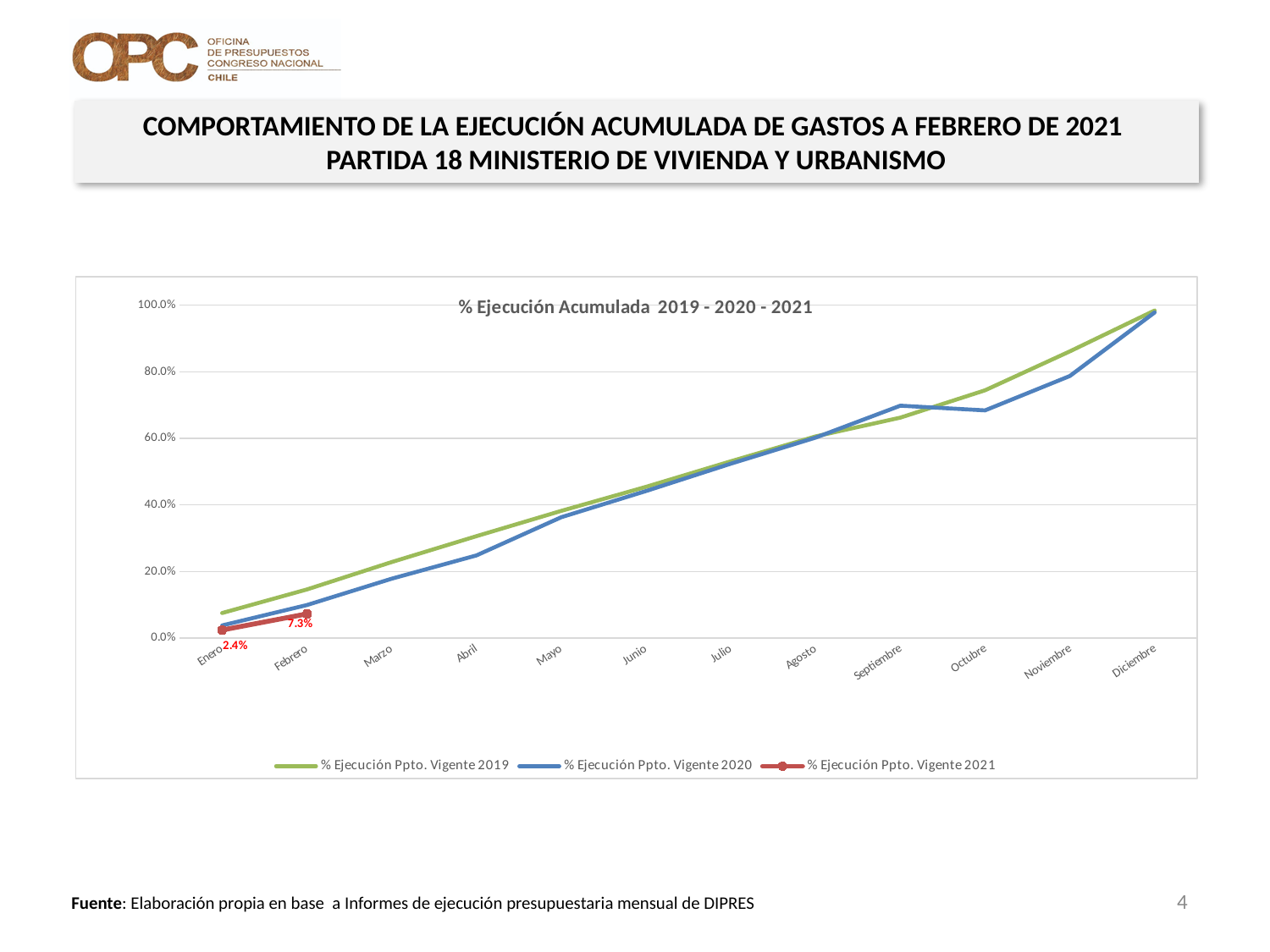
What kind of chart is shown on the slide? line chart Is the value for % Ejecución Ppto. Vigente 2020 in Junio greater or less than 60%? less Does the % Ejecución Ppto. Vigente 2019 series rise or fall from Enero to Diciembre? rise What is the value of % Ejecución Ppto. Vigente 2021 in Febrero? 7.3% What is the value of % Ejecución Ppto. Vigente 2021 in Enero? 2.4% What is the title of the chart? % Ejecución Acumulada 2019 - 2020 - 2021 In Noviembre, which series is higher: % Ejecución Ppto. Vigente 2019 or % Ejecución Ppto. Vigente 2020? % Ejecución Ppto. Vigente 2019 By how much did % Ejecución Ppto. Vigente 2021 increase from Enero to Febrero? 4.9% How many months are shown on the x axis? 12 Is the value for % Ejecución Ppto. Vigente 2019 in Noviembre greater or less than 80%? greater Is the value for % Ejecución Ppto. Vigente 2020 in Abril greater or less than 40%? less How many series does the legend list? 3